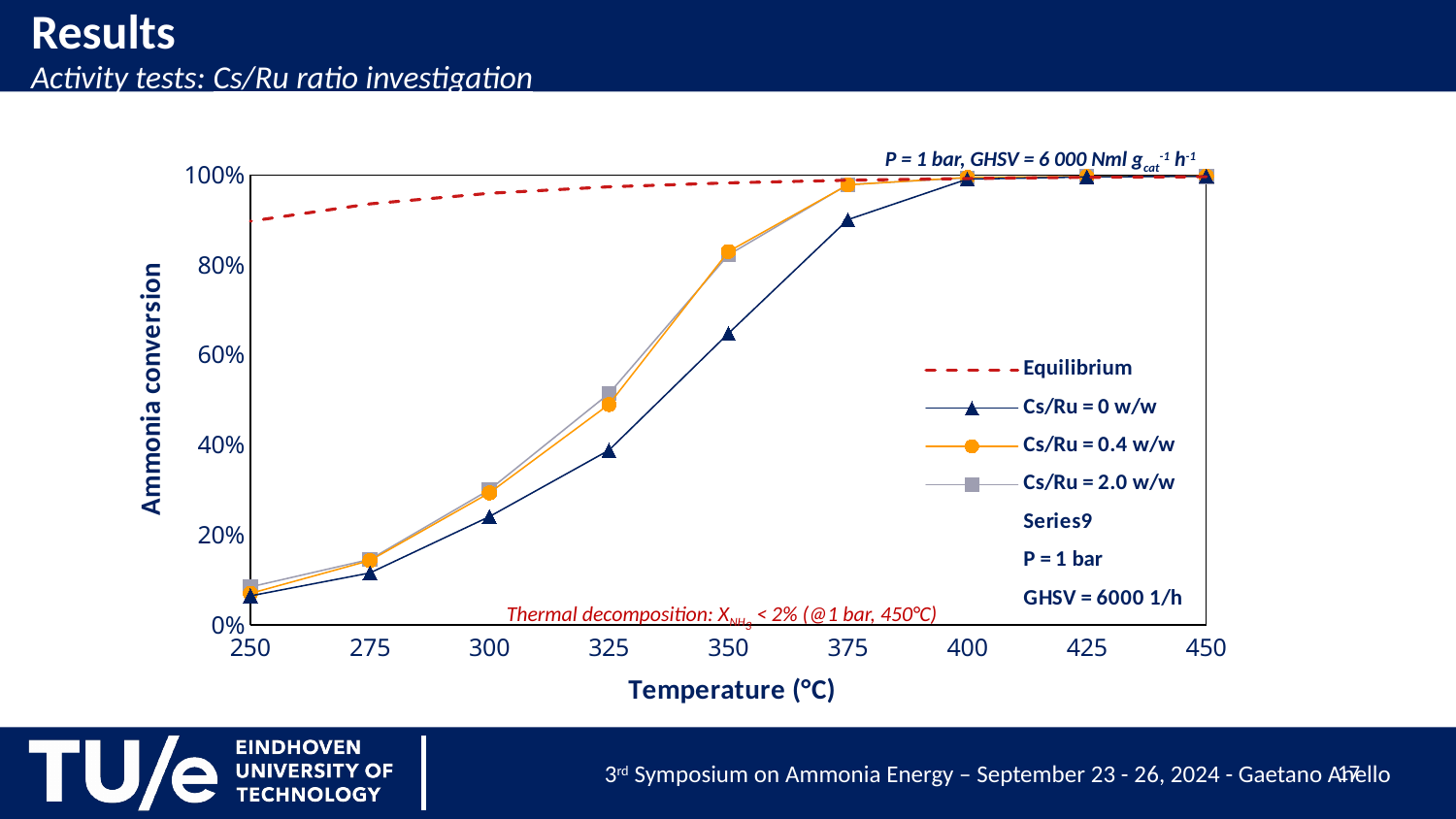
What is the title of the x axis? Temperature (°C) Is the ammonia conversion for Cs/Ru = 0.4 w/w at 325°C greater or less than 60%? less Is the Equilibrium value at 250°C greater or less than 80%? greater Is the ammonia conversion for Cs/Ru = 0 w/w at 300°C greater or less than 20%? greater At 350°C, which series has the higher ammonia conversion, Cs/Ru = 0 w/w or Cs/Ru = 0.4 w/w? Cs/Ru = 0.4 w/w What kind of chart is shown on the slide? line chart How many temperature points are plotted for the Cs/Ru = 0 w/w series? 9 Does the ammonia conversion for Cs/Ru = 0 w/w rise or fall as temperature increases from 250°C to 400°C? rise What is the title of the y axis? Ammonia conversion How many Cs/Ru catalyst series are plotted in the chart? 3